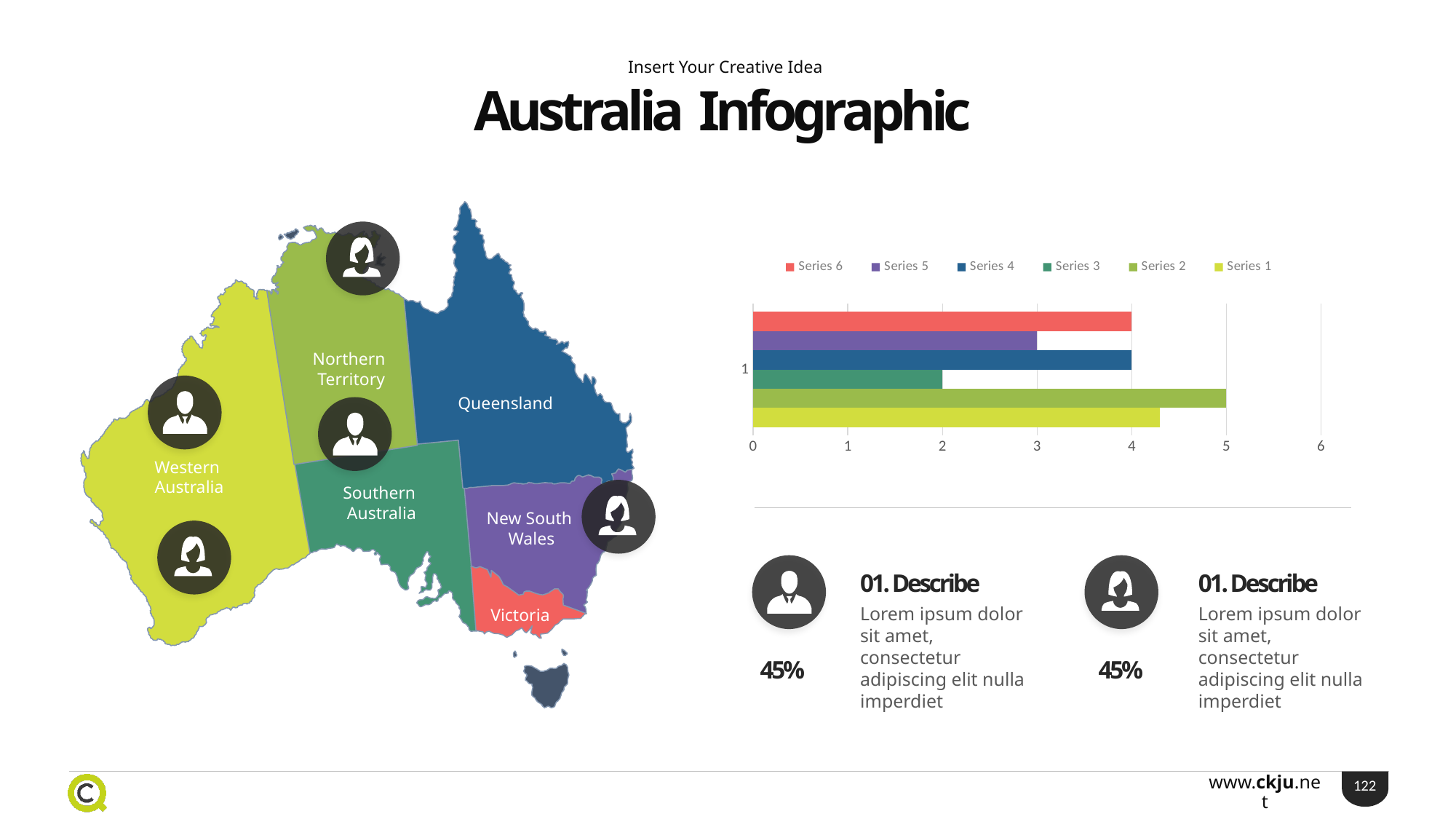
Which series has the lowest value in the chart? Series 3 What kind of chart is shown on the slide? bar chart What is the value of Series 5 in the chart? 3 Which is larger, the value of Series 2 or the value of Series 5? Series 2 What is the difference between the values of Series 2 and Series 3? 3 Is the value for Series 1 greater or less than 4? greater What is the value of Series 6 in the chart? 4 What is the value of Series 2 in the chart? 5 How many categories are plotted on the chart's vertical axis? 1 Which series has the highest value in the chart? Series 2 What is the value of Series 3 in the chart? 2 How many series does the chart legend list? 6